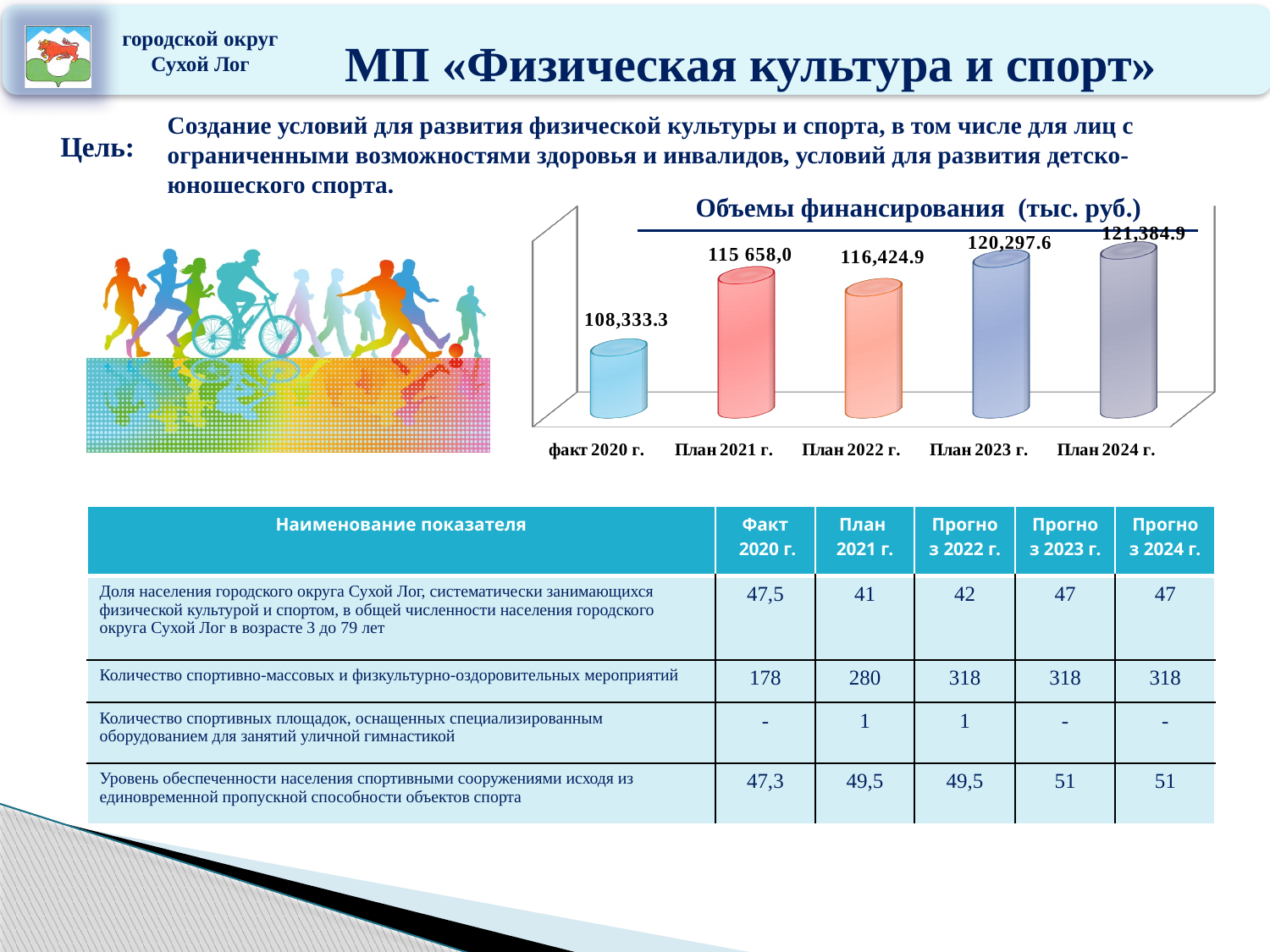
What is the value for План 2024 г. in the chart? 121,384.9 What is the value for факт 2020 г. in the chart? 108,333.3 Which category has the highest value in the chart? План 2024 г. How many categories are plotted in the chart? 5 What is the title of the chart on the slide? Объемы финансирования (тыс. руб.) What is the value for План 2023 г. in the chart? 120,297.6 Do the values in the chart rise or fall from факт 2020 г. to План 2024 г.? rise What is the difference between the values for План 2024 г. and факт 2020 г.? 13,051.6 Which category has the lowest value in the chart? факт 2020 г. What type of chart is shown on the slide? bar chart What is the value for План 2021 г. in the chart? 115 658,0 What is the value for План 2022 г. in the chart? 116,424.9